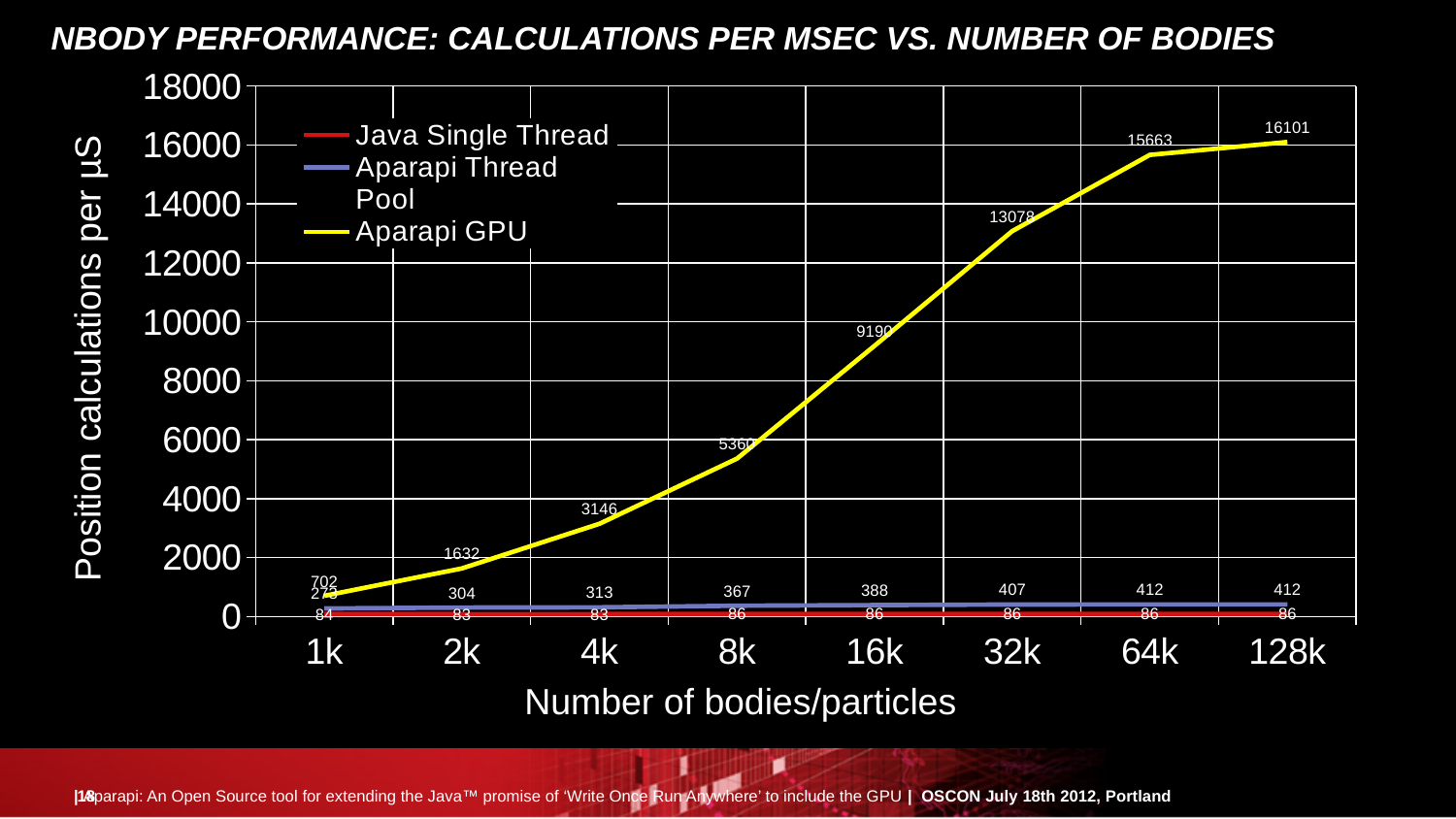
What is the value for Aparapi Thread Pool at 16k bodies? 388 What is the value for Java Single Thread at 2k bodies? 83 What is the difference between the Aparapi GPU values at 64k and 32k bodies? 2585 How many categories are shown on the x axis? 8 What is the value for Aparapi GPU at 8k bodies? 5360 At which number of bodies does Aparapi GPU reach its highest value? 128k How many series does the legend list? 3 Does the Aparapi GPU series rise or fall as the number of bodies increases? rise Which is larger at 4k bodies: Aparapi Thread Pool or Java Single Thread? Aparapi Thread Pool What type of chart is shown on the slide? line chart What is the value for Aparapi GPU at 128k bodies? 16101 What is the label of the y axis? Position calculations per µS